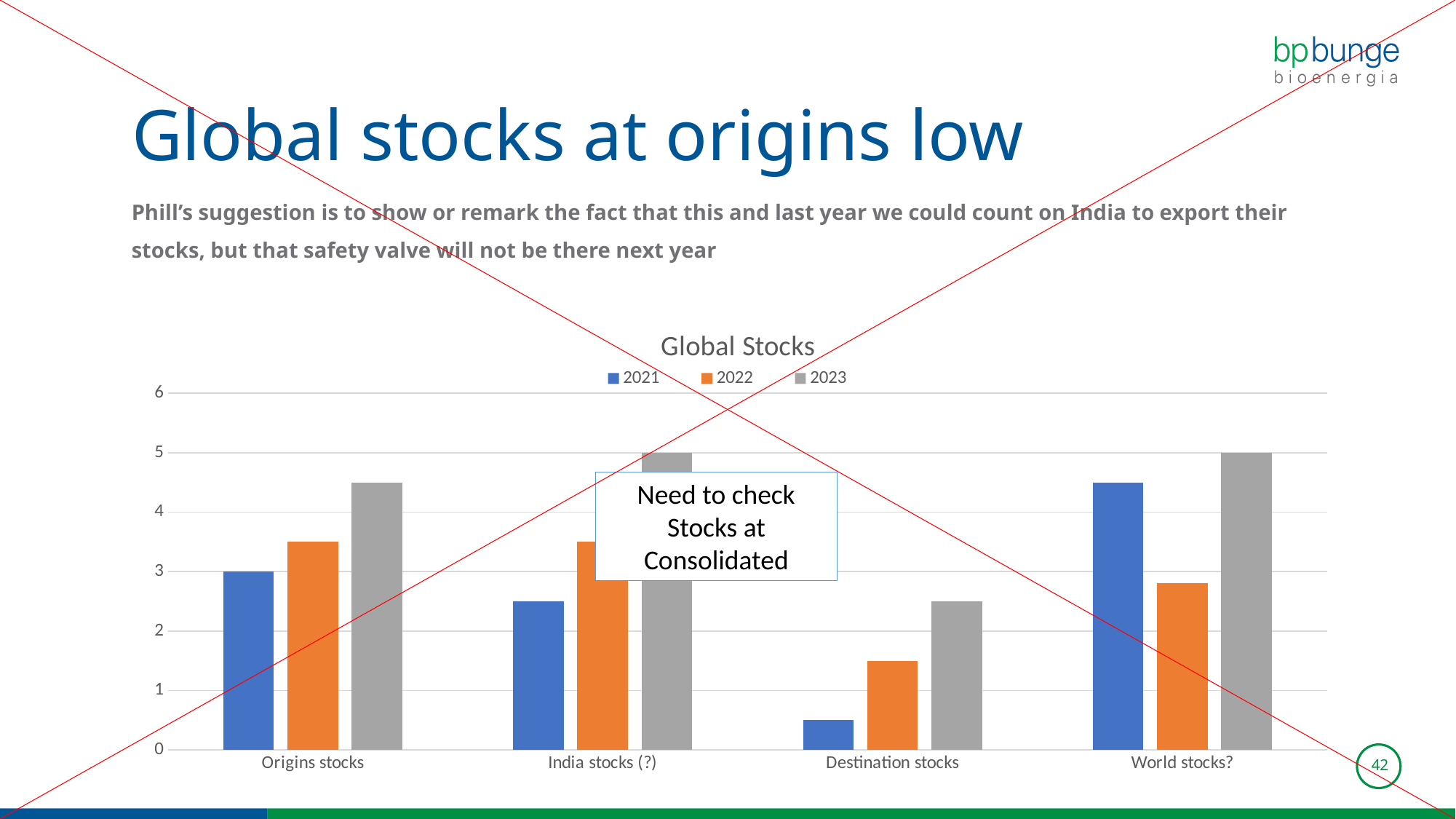
How many categories are shown on the x axis of the Global Stocks chart? 4 Is the value for Origins stocks in 2023 greater or less than 4 in the Global Stocks chart? greater Is the value for World stocks? in 2022 greater or less than 3 in the Global Stocks chart? less In the Global Stocks chart, which is larger for World stocks?: the 2021 value or the 2022 value? 2021 Which category has the lowest 2023 value in the Global Stocks chart? Destination stocks What is the value for Origins stocks in 2021 in the Global Stocks chart? 3 Is the value for Destination stocks in 2021 greater or less than 1 in the Global Stocks chart? less What is the value for India stocks (?) in 2023 in the Global Stocks chart? 5 Which category has the lowest 2021 value in the Global Stocks chart? Destination stocks How many series does the legend of the Global Stocks chart list? 3 What kind of chart is the Global Stocks chart? bar chart Which series is shown in orange in the Global Stocks chart? 2022